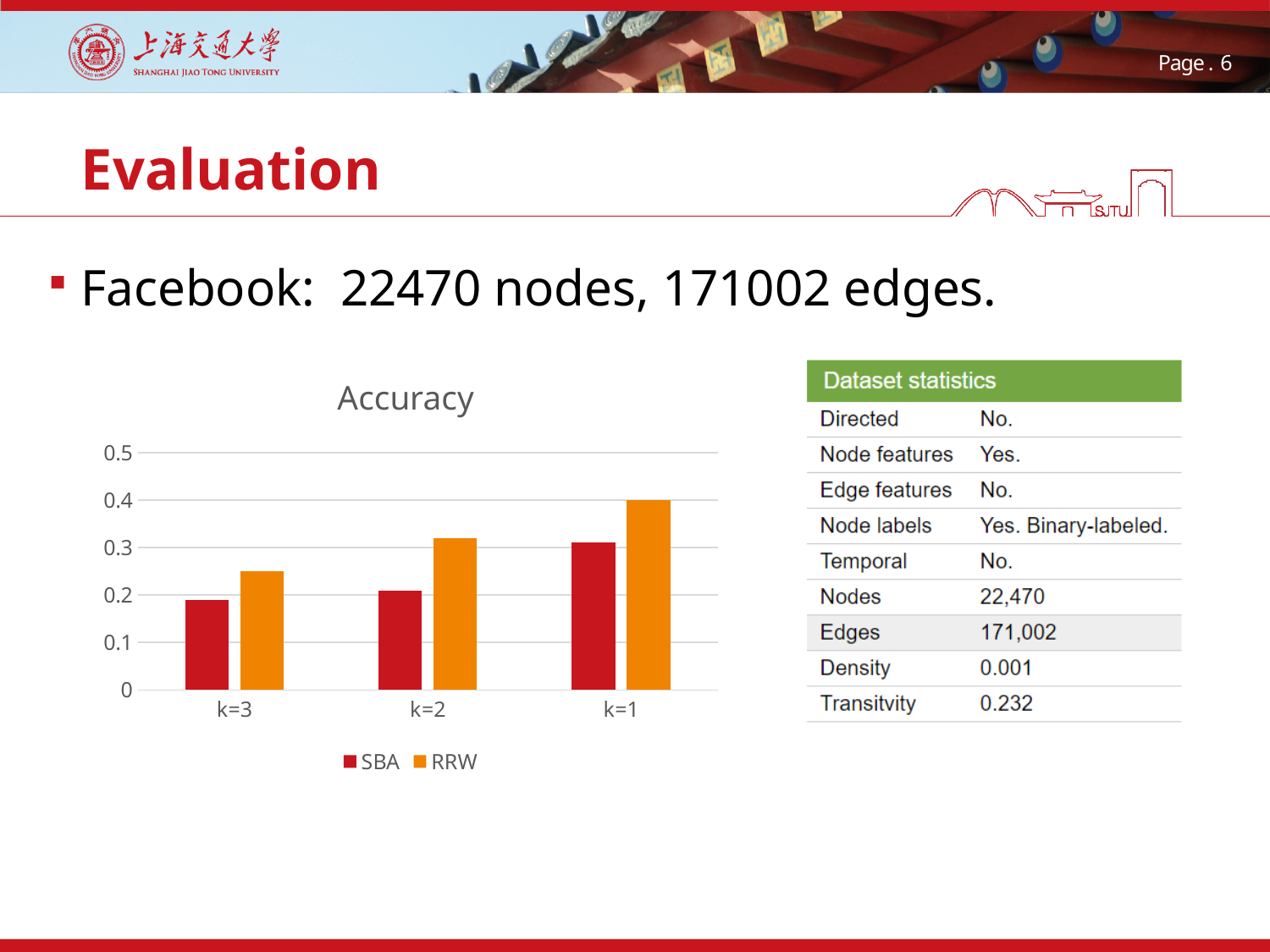
Which colour represents the SBA series in the chart? red Is the RRW value for k=3 greater or less than 0.3? less What kind of chart is shown on the slide? bar chart For which category is the RRW value highest? k=1 For which category is the SBA value lowest? k=3 Do the SBA values rise or fall moving along the x axis from k=3 to k=1? rise How many categories are shown on the x axis of the chart? 3 What is the title of the chart? Accuracy How many series does the chart's legend list? 2 Is the SBA value for k=1 greater or less than 0.2? greater At k=2, which series has the larger value, SBA or RRW? RRW